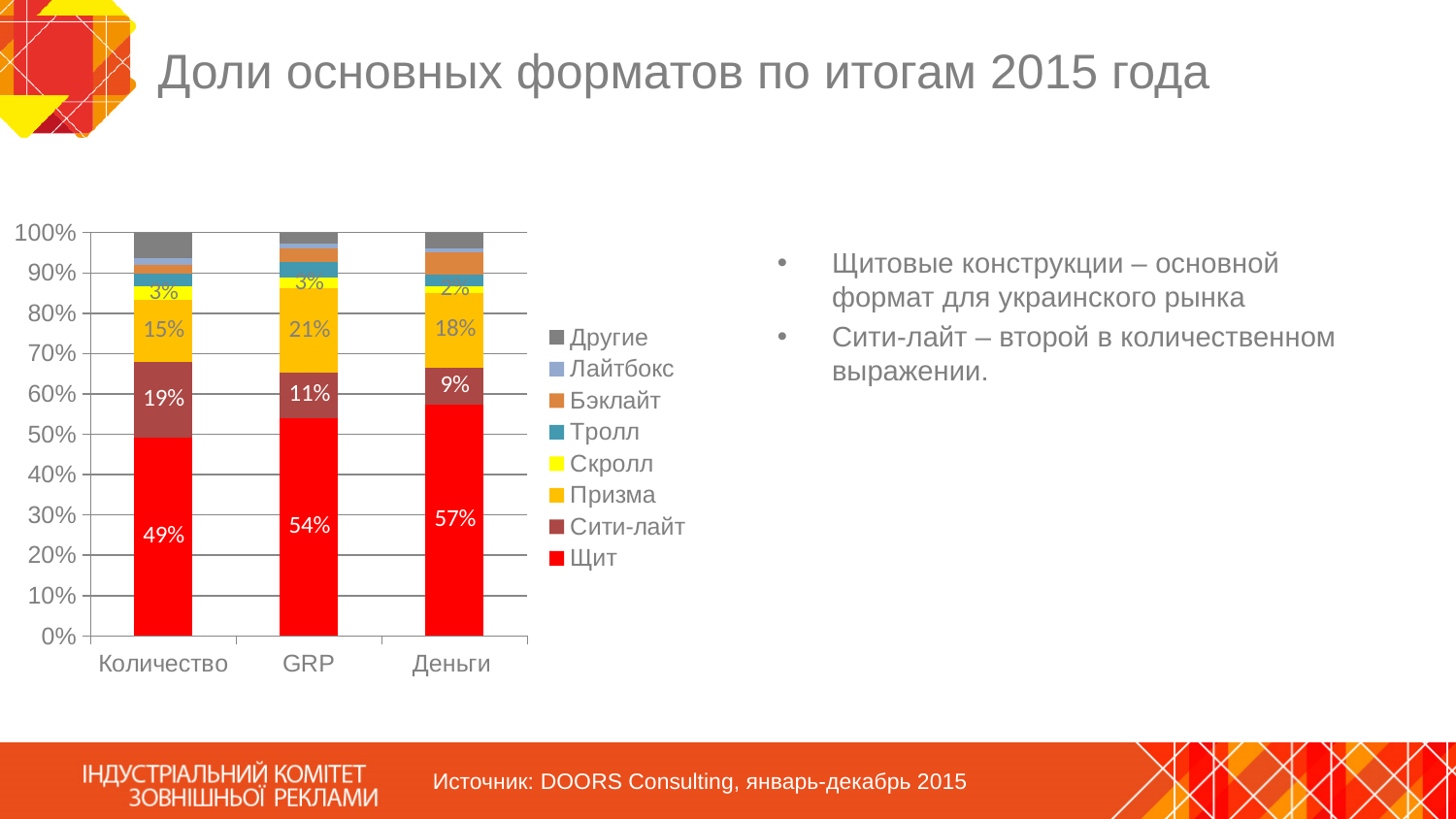
What kind of chart is shown on the slide? Stacked bar chart How many categories are shown on the x axis? 3 Which is larger: the Призма share in GRP or in Количество? GRP What is the value for Сити-лайт in the GRP bar? 11% What is the title of the slide containing the chart? Доли основных форматов по итогам 2015 года In which category does Щит have the highest share? Деньги How many series does the legend list? 8 What is the value for Призма in the Деньги bar? 18% In which category does Сити-лайт have the lowest share? Деньги What is the difference between the Щит share in Деньги and in Количество? 8% What is the value for Скролл in the Деньги bar? 2% What is the value for Щит in the Количество bar? 49%